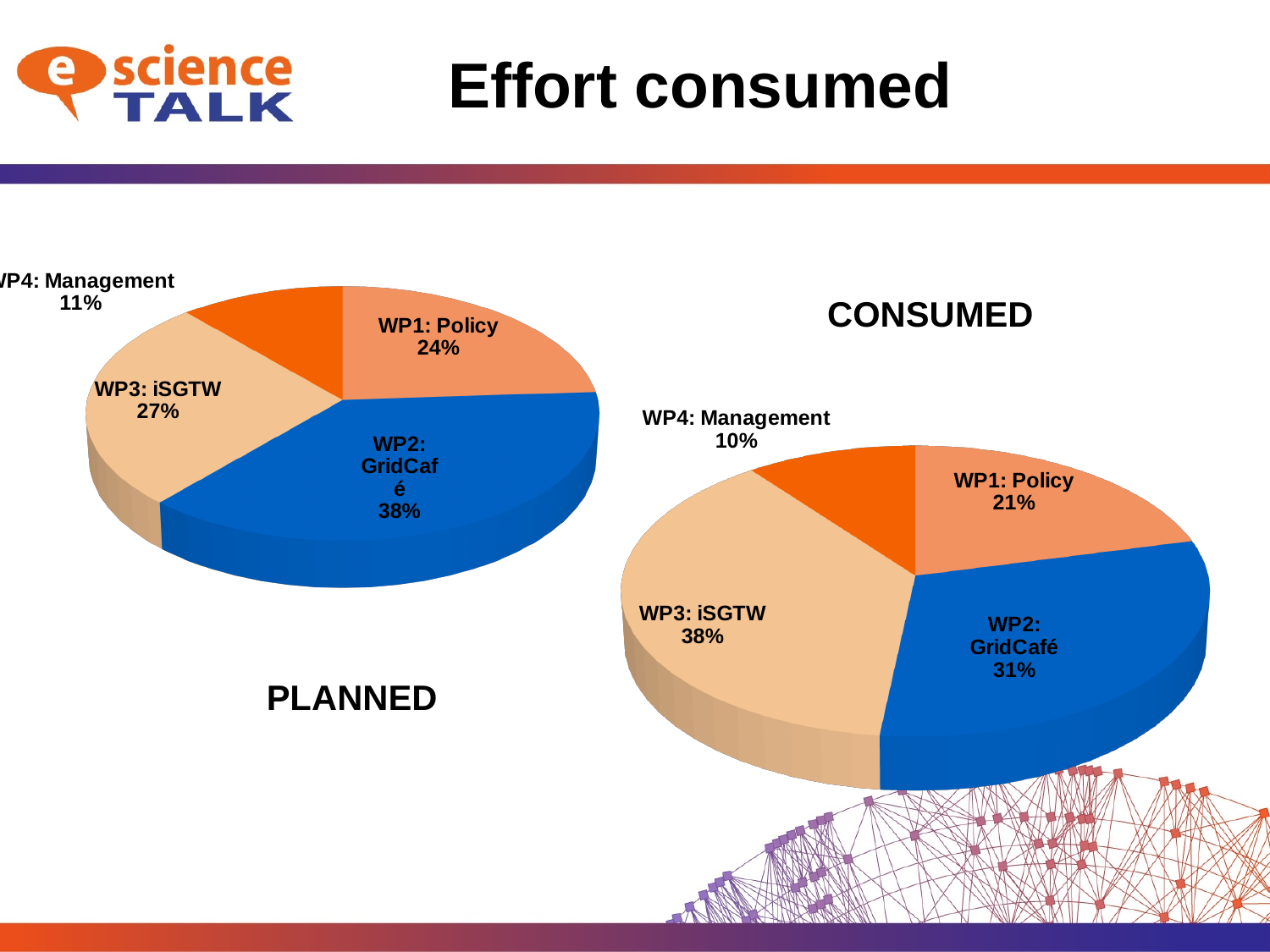
In the CONSUMED pie chart, which work package has the smallest share? WP4: Management In the PLANNED pie chart, which is larger: the share of WP1: Policy or the share of WP3: iSGTW? WP3: iSGTW In the CONSUMED pie chart, what share does WP3: iSGTW have? 38% In the PLANNED pie chart, what share does WP2: GridCafé have? 38% In the PLANNED pie chart, what is the combined share of WP1: Policy and WP4: Management? 35% What is the difference between the WP2: GridCafé share in the PLANNED chart and in the CONSUMED chart? 7 percentage points In the CONSUMED pie chart, what share does WP1: Policy have? 21% In the PLANNED pie chart, which work package has the largest share? WP2: GridCafé What is the title of the slide containing the two pie charts? Effort consumed In the CONSUMED pie chart, which work package has the largest share? WP3: iSGTW How many slices does the CONSUMED pie chart have? 4 What kind of chart is used for the PLANNED data? Pie chart